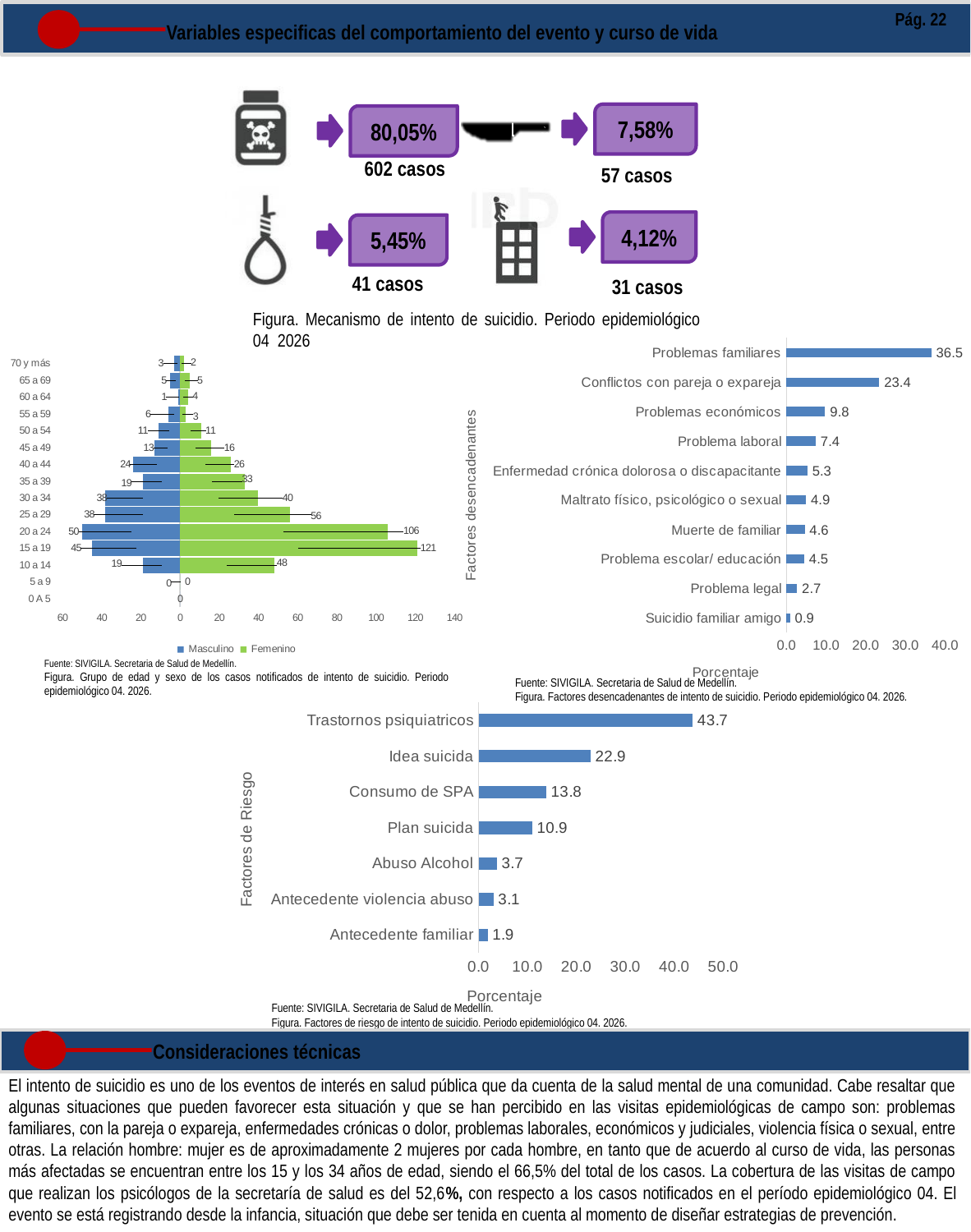
In the 'Factores de Riesgo' chart, which is larger: Consumo de SPA or Plan suicida? Consumo de SPA In the 'Factores desencadenantes' chart, which category has the lowest value? Suicidio familiar amigo In the 'Factores desencadenantes' chart, what is the difference between Problemas familiares and Conflictos con pareja o expareja? 13.1 In the 'Factores de Riesgo' chart, which category has the highest value? Trastornos psiquiatricos How many series does the legend of the age group and sex chart (bottom left) list? 2 How many categories are shown in the 'Factores de Riesgo' chart? 7 How many categories are shown in the 'Factores desencadenantes' chart? 10 In the age group and sex chart (bottom left), what is the Masculino value for the 20 a 24 age group? 50 In the 'Factores desencadenantes' chart, what is the value for Problemas familiares? 36.5 In the age group and sex chart (bottom left), what is the Femenino value for the 15 a 19 age group? 121 In the 'Factores de Riesgo' chart, what is the value for Idea suicida? 22.9 What kind of chart is the 'Factores de Riesgo' chart? Bar chart